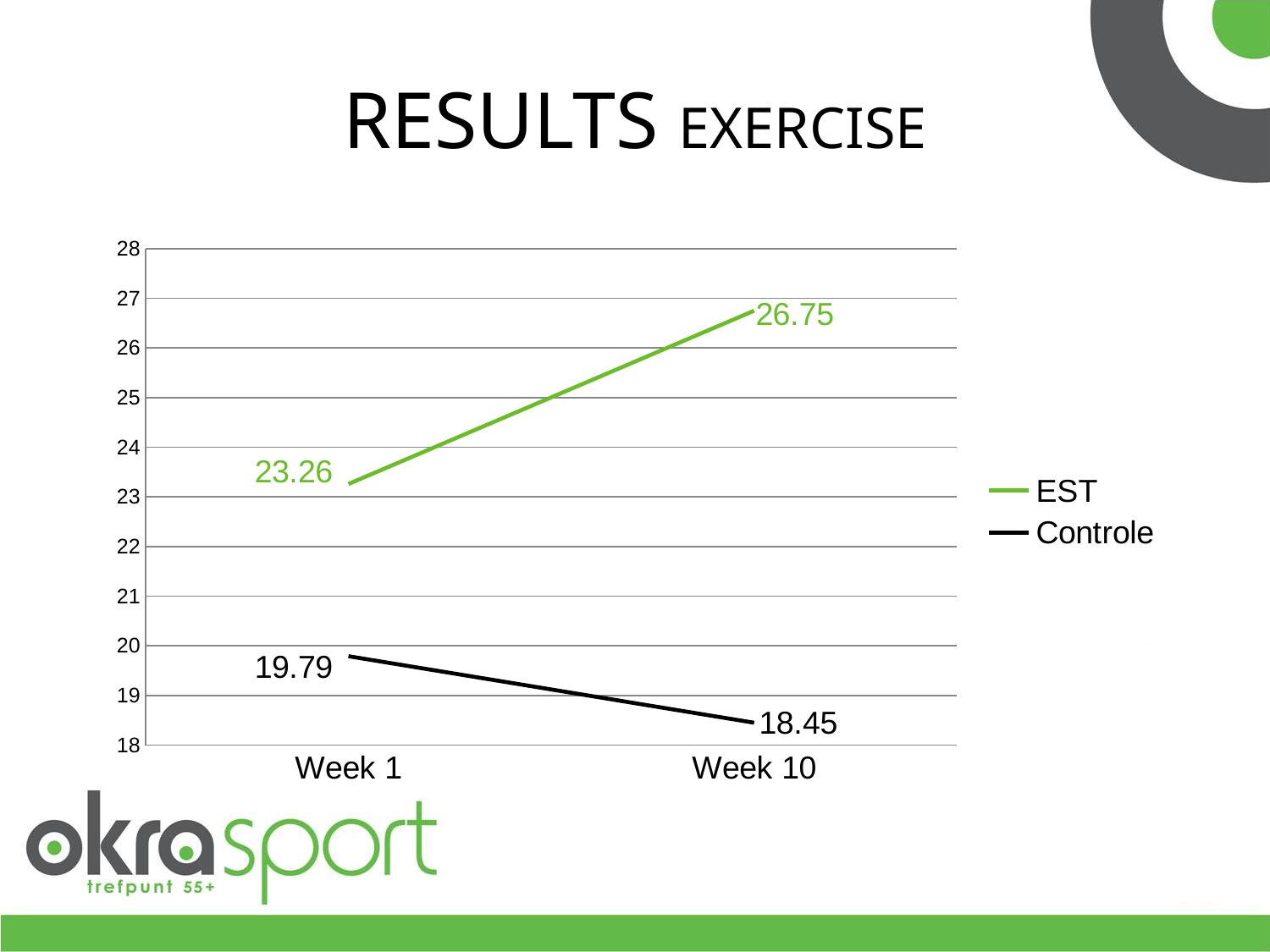
What is the value for Controle at Week 10? 18.45 What is the difference between the EST values at Week 10 and Week 1? 3.49 Does the EST series rise or fall from Week 1 to Week 10? rise What is the value for Controle at Week 1? 19.79 What is the value for EST at Week 1? 23.26 How many series does the legend list? 2 Does the Controle series rise or fall from Week 1 to Week 10? fall What is the difference between the EST and Controle values at Week 1? 3.47 Which series has the higher value at Week 10, EST or Controle? EST What is the value for EST at Week 10? 26.75 What colour is the EST line? green What kind of chart is shown on the slide? line chart